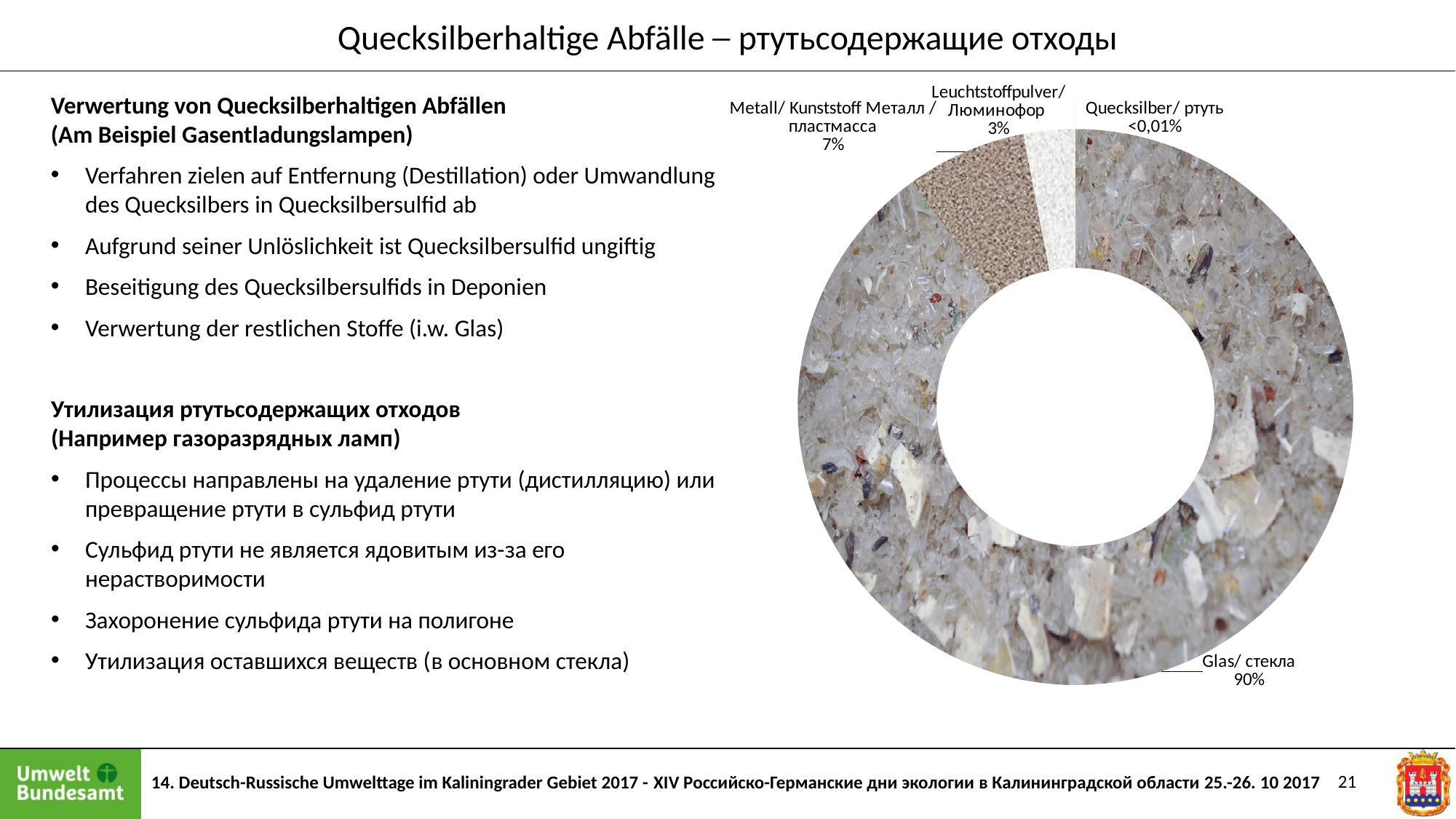
What percentage is shown for Metall/ Kunststoff (Металл / пластмасса)? 7% Which category has the smallest share of the chart? Quecksilber/ ртуть What share of the chart does Glas/ стекла account for? 90% Which category has the largest share of the chart? Glas/ стекла What is the difference in percentage points between Glas/ стекла and Metall/ Kunststoff? 83 What kind of chart is shown on the slide? doughnut chart What value is shown for Quecksilber/ ртуть? <0,01% What is the difference in percentage points between Metall/ Kunststoff and Leuchtstoffpulver/ Люминофор? 4 How many categories (slices) does the chart show? 4 Which is larger, the share for Metall/ Kunststoff or the share for Leuchtstoffpulver/ Люминофор? Metall/ Kunststoff What percentage is shown for Leuchtstoffpulver/ Люминофор? 3% Is the share for Glas/ стекла greater or less than 50%? greater